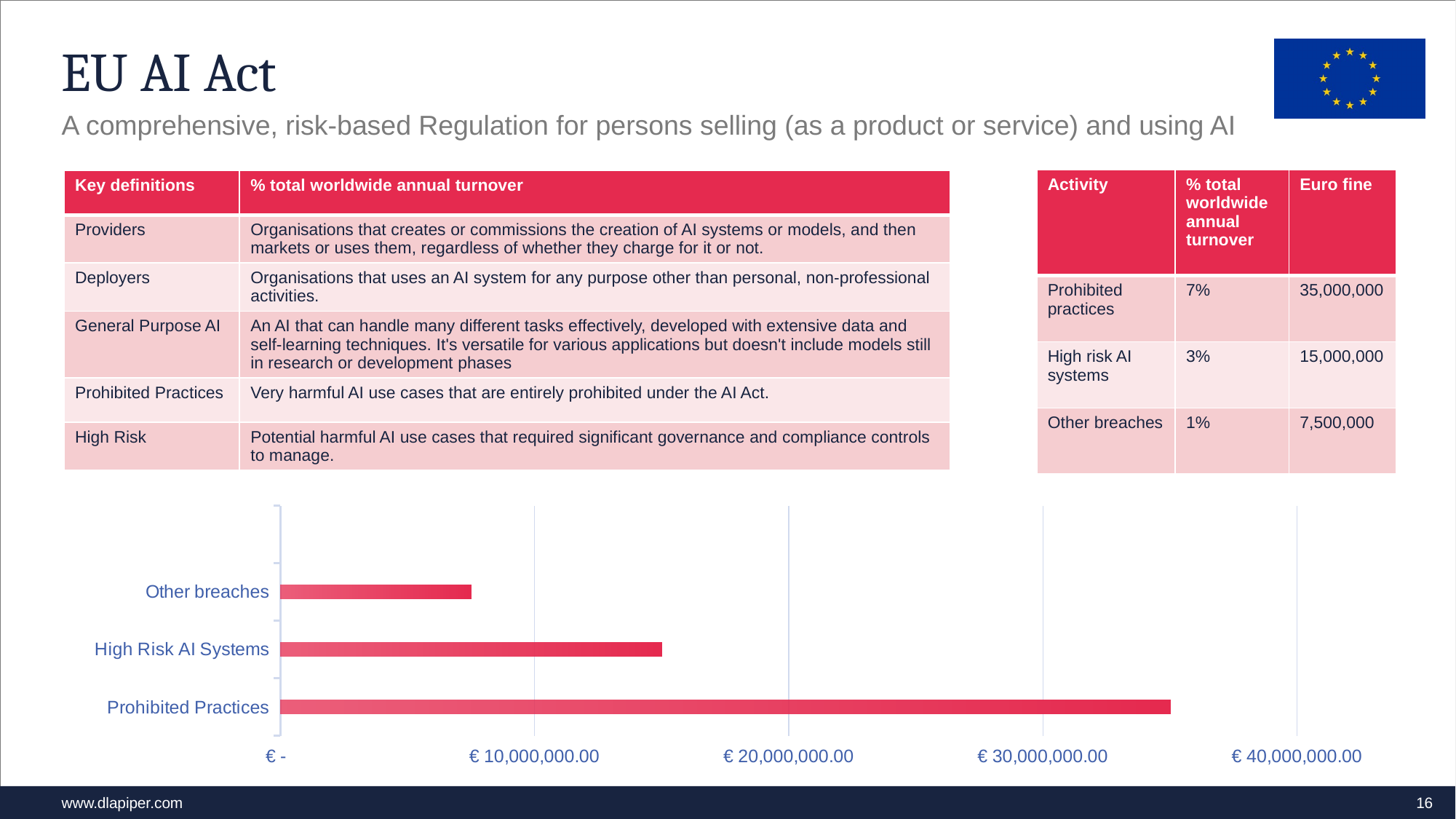
What is the highest value shown on the chart's horizontal axis? € 40,000,000.00 Is the value for High Risk AI Systems greater or less than € 20,000,000.00? less Is the value for Prohibited Practices greater or less than € 30,000,000.00? greater Is the value for Other breaches greater or less than € 10,000,000.00? less Which is larger in the chart, the value for High Risk AI Systems or the value for Other breaches? High Risk AI Systems Which category has the shortest bar in the chart? Other breaches Which category has the longest bar in the chart? Prohibited Practices What kind of chart is shown at the bottom of the slide? bar chart How many categories does the bar chart show? 3 Are the bars in the chart horizontal or vertical? horizontal